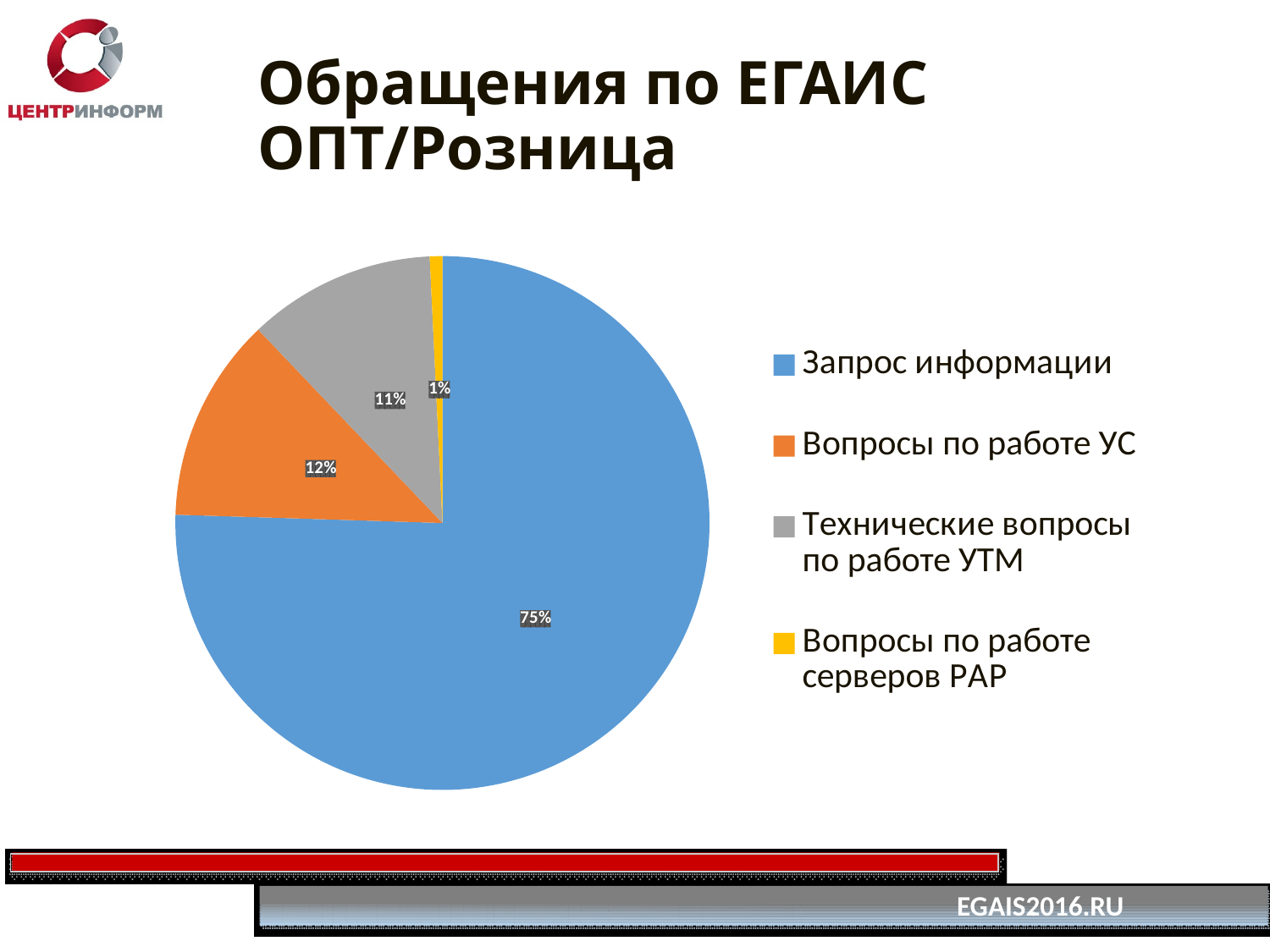
What share of the pie does "Технические вопросы по работе УТМ" have? 11% Which category has the smallest slice of the pie? Вопросы по работе серверов РАР Which is larger: the slice for "Запрос информации" or the slice for "Технические вопросы по работе УТМ"? Запрос информации Which category has the largest slice of the pie? Запрос информации How many categories does the pie chart show? 4 What is the difference in percentage points between "Запрос информации" and "Вопросы по работе УС"? 63 What kind of chart is shown on the slide? pie chart What share of the pie does "Запрос информации" have? 75% What share of the pie does "Вопросы по работе серверов РАР" have? 1% What colour is the slice for "Вопросы по работе УС"? orange What is the title of the slide containing the chart? Обращения по ЕГАИС ОПТ/Розница